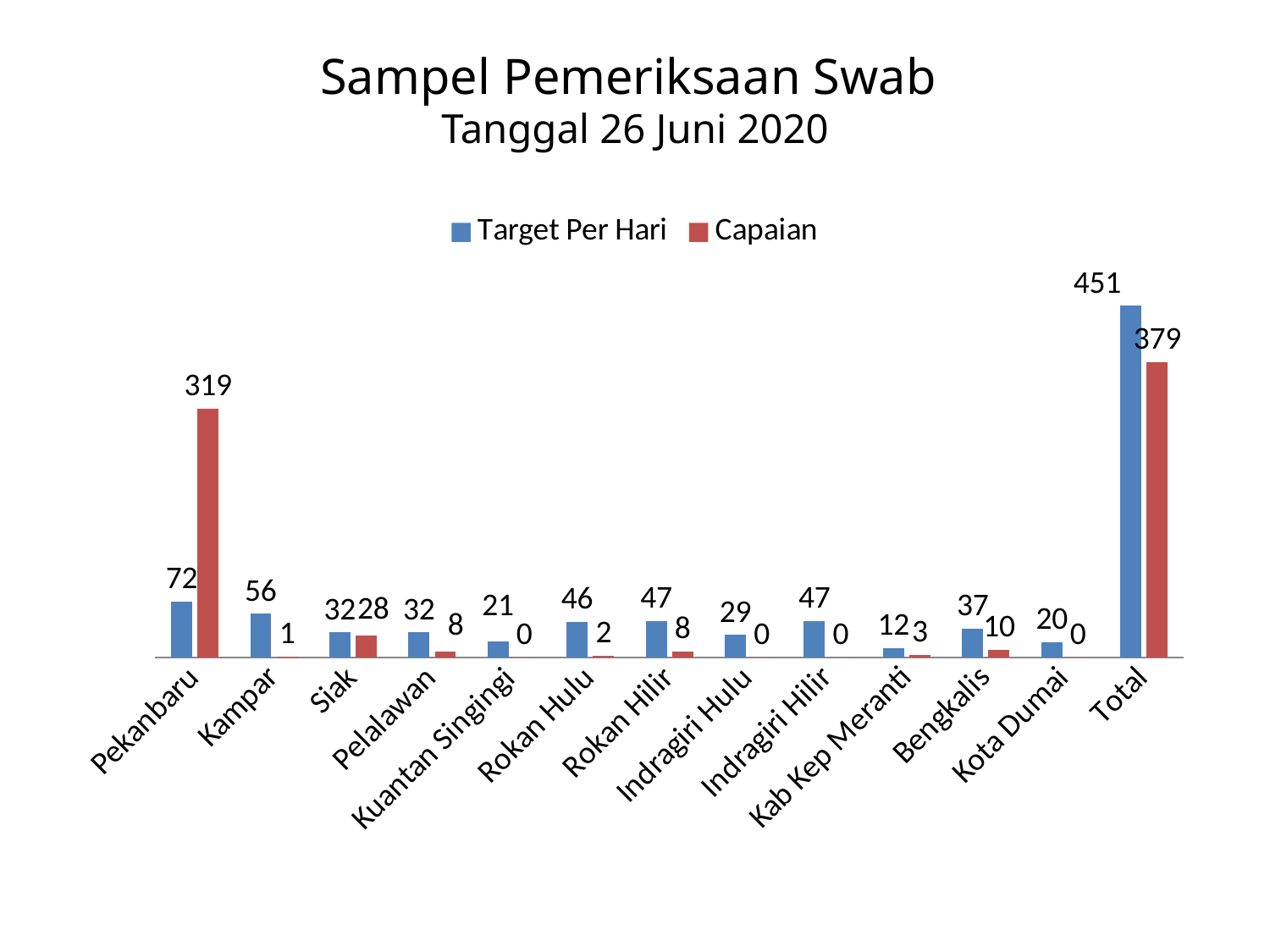
How many series does the legend list? 2 What is the Target Per Hari value for Total? 451 What is the difference between Target Per Hari and Capaian for Total? 72 What is the Target Per Hari value for Pekanbaru? 72 Excluding Total, which category has the lowest Target Per Hari value? Kab Kep Meranti How many categories are shown on the x axis? 13 What kind of chart is shown? Bar chart Excluding Total, which category has the highest Capaian value? Pekanbaru What is the title of the chart? Sampel Pemeriksaan Swab Tanggal 26 Juni 2020 What is the Capaian value for Siak? 28 What is the Capaian value for Pekanbaru? 319 Which is larger for Kampar, Target Per Hari or Capaian? Target Per Hari